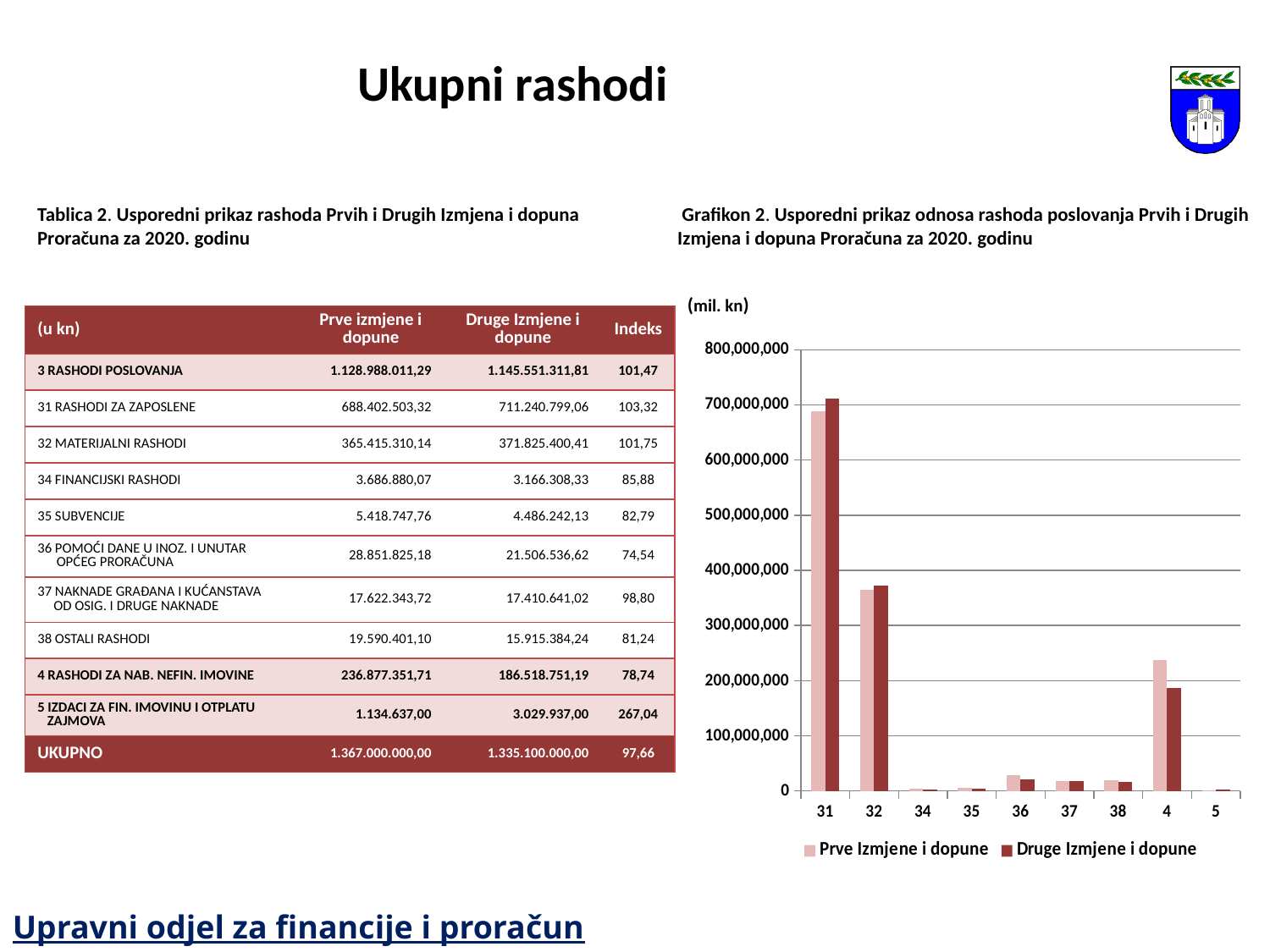
In Grafikon 2, for category 4, which series has the larger value: Prve Izmjene i dopune or Druge Izmjene i dopune? Prve Izmjene i dopune How many categories are shown on the x axis of Grafikon 2? 9 In Grafikon 2, is the Prve Izmjene i dopune value for category 32 greater or less than 400,000,000? less In Grafikon 2, is the Prve Izmjene i dopune value for category 36 greater or less than 100,000,000? less How many series does the legend of Grafikon 2 list? 2 In Grafikon 2, is the Druge Izmjene i dopune value for category 4 greater or less than 200,000,000? less What are the two legend entries in Grafikon 2? Prve Izmjene i dopune; Druge Izmjene i dopune What kind of chart is Grafikon 2? bar chart In Grafikon 2, which category has the highest value for Prve Izmjene i dopune? 31 In Grafikon 2, which category has the highest value for Druge Izmjene i dopune? 31 In Grafikon 2, which category has the larger Prve Izmjene i dopune value: 32 or 4? 32